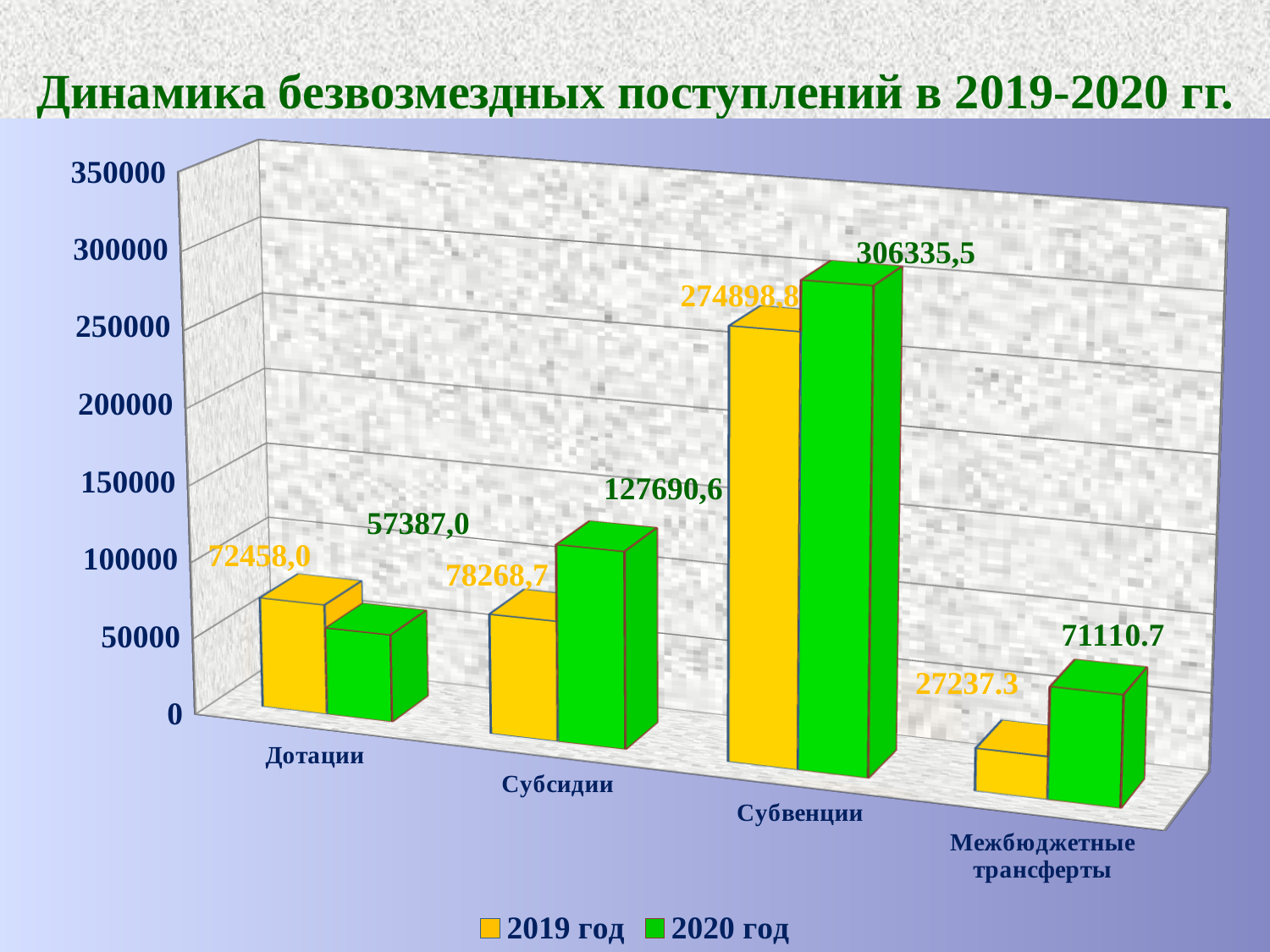
What is the value for Дотации in the 2019 год series? 72458,0 How many categories are shown on the x axis? 4 What is the value for Субвенции in the 2020 год series? 306335,5 What is the difference between the 2019 год and 2020 год values for Дотации? 15071,0 What is the value for Межбюджетные трансферты in the 2020 год series? 71110.7 Which is larger for Субсидии: the 2019 год value or the 2020 год value? 2020 год Which category has the lowest value in the 2020 год series? Дотации How many series does the legend list? 2 What is the difference between the 2020 год and 2019 год values for Субвенции? 31436,7 What kind of chart is shown on the slide? bar chart Is the 2019 год value for Субвенции greater or less than 250000? greater Which category has the highest value in the 2019 год series? Субвенции